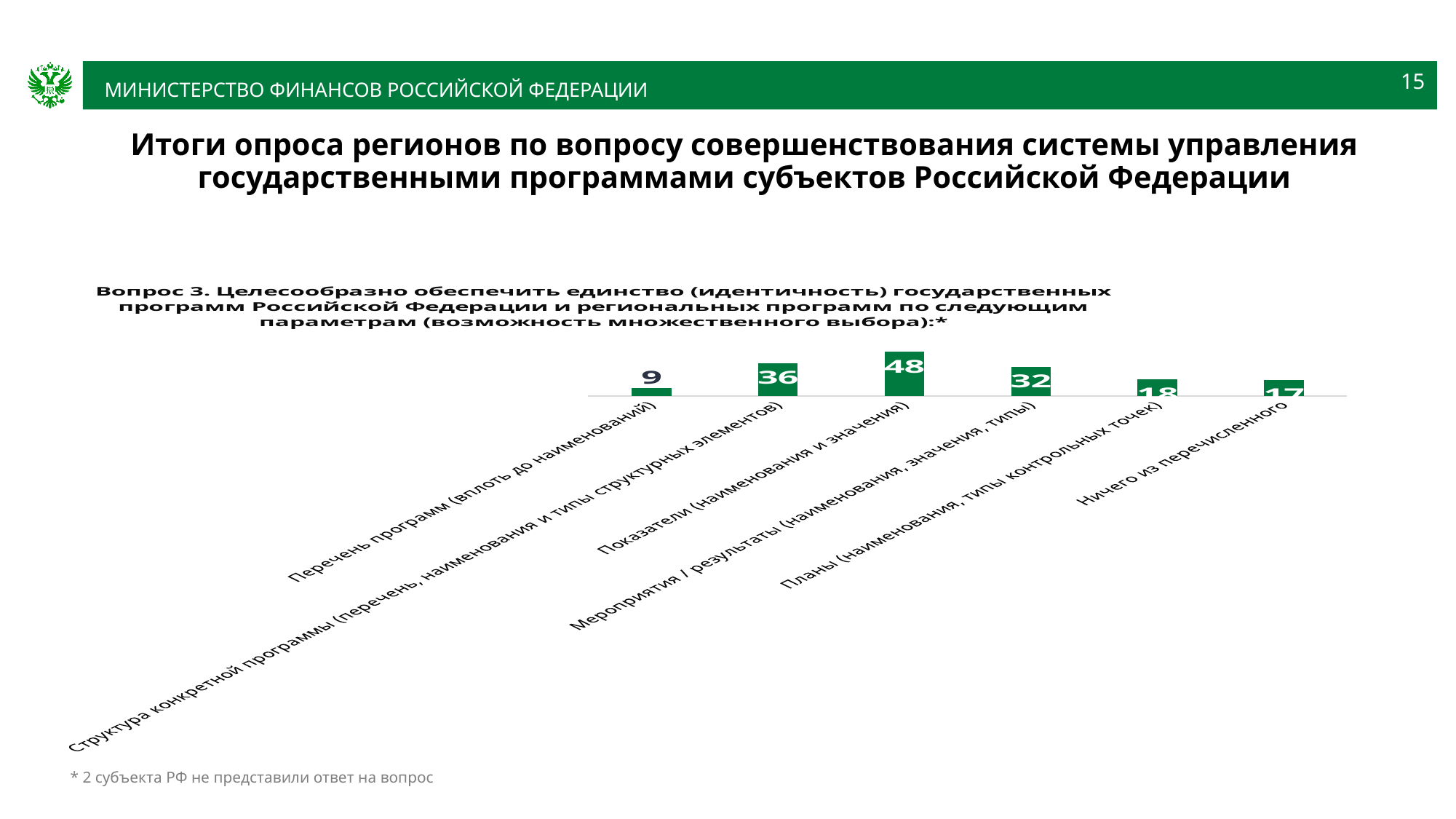
What is the difference between the values for «Мероприятия / результаты (наименования, значения, типы)» and «Перечень программ (вплоть до наименований)»? 23 Which category has the lowest value? Перечень программ (вплоть до наименований) Which is larger: the value for «Структура конкретной программы» or the value for «Мероприятия / результаты»? Структура конкретной программы How many categories are shown in the chart? 6 What is the value for «Показатели (наименования и значения)»? 48 What is the value for «Ничего из перечисленного»? 17 What is the value for «Перечень программ (вплоть до наименований)»? 9 What is the value for «Планы (наименования, типы контрольных точек)»? 18 What is the difference between the values for «Показатели (наименования и значения)» and «Структура конкретной программы (перечень, наименования и типы структурных элементов)»? 12 What kind of chart is shown on the slide? Bar chart What colour are the bars in the chart? Green Which category has the highest value? Показатели (наименования и значения)